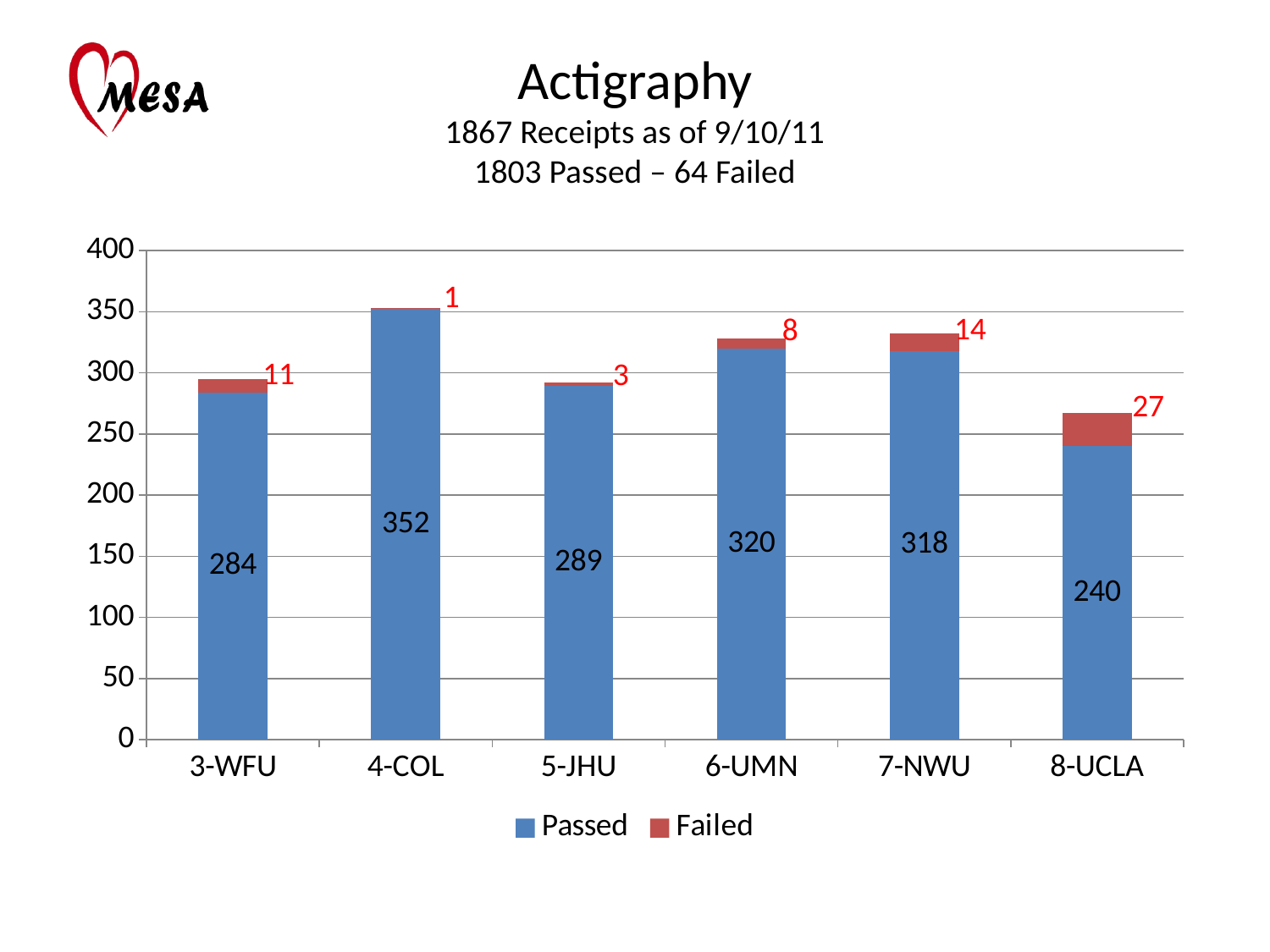
What is the total of the stacked bar for 8-UCLA? 267 How many series does the legend list? 2 Which is larger, the Failed value for 3-WFU or the Failed value for 7-NWU? 7-NWU What is the Failed value for 8-UCLA? 27 What is the difference between the Passed values for 6-UMN and 8-UCLA? 80 What kind of chart is shown? stacked bar chart What is the Passed value for 4-COL? 352 Which site has the lowest Failed value? 4-COL Which site has the highest Passed value? 4-COL Is the Passed value for 5-JHU greater or less than 300? less What is the Passed value for 7-NWU? 318 How many sites are shown on the x axis? 6